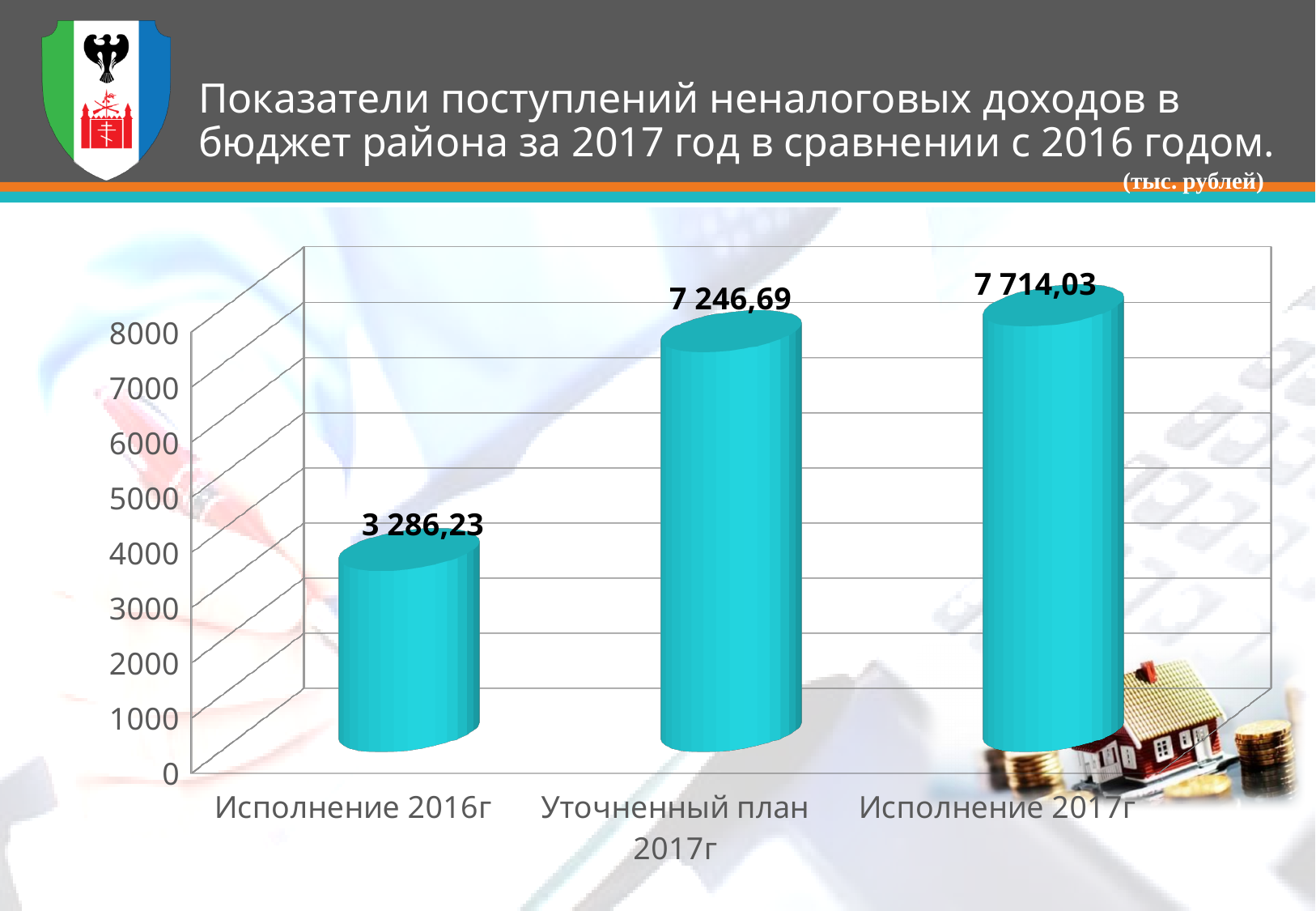
How many categories are shown on the chart? 3 What kind of chart is shown on the slide? bar chart Which is larger, Исполнение 2016г or Уточненный план 2017г? Уточненный план 2017г In what units are the values on the chart given? тыс. рублей What is the value for Исполнение 2016г? 3 286,23 Is the value for Исполнение 2016г greater or less than 4000? less Which category has the lowest value? Исполнение 2016г What is the value for Уточненный план 2017г? 7 246,69 Which category has the highest value? Исполнение 2017г What is the value for Исполнение 2017г? 7 714,03 What is the difference between Исполнение 2017г and Исполнение 2016г? 4 427,80 What is the difference between Исполнение 2017г and Уточненный план 2017г? 467,34